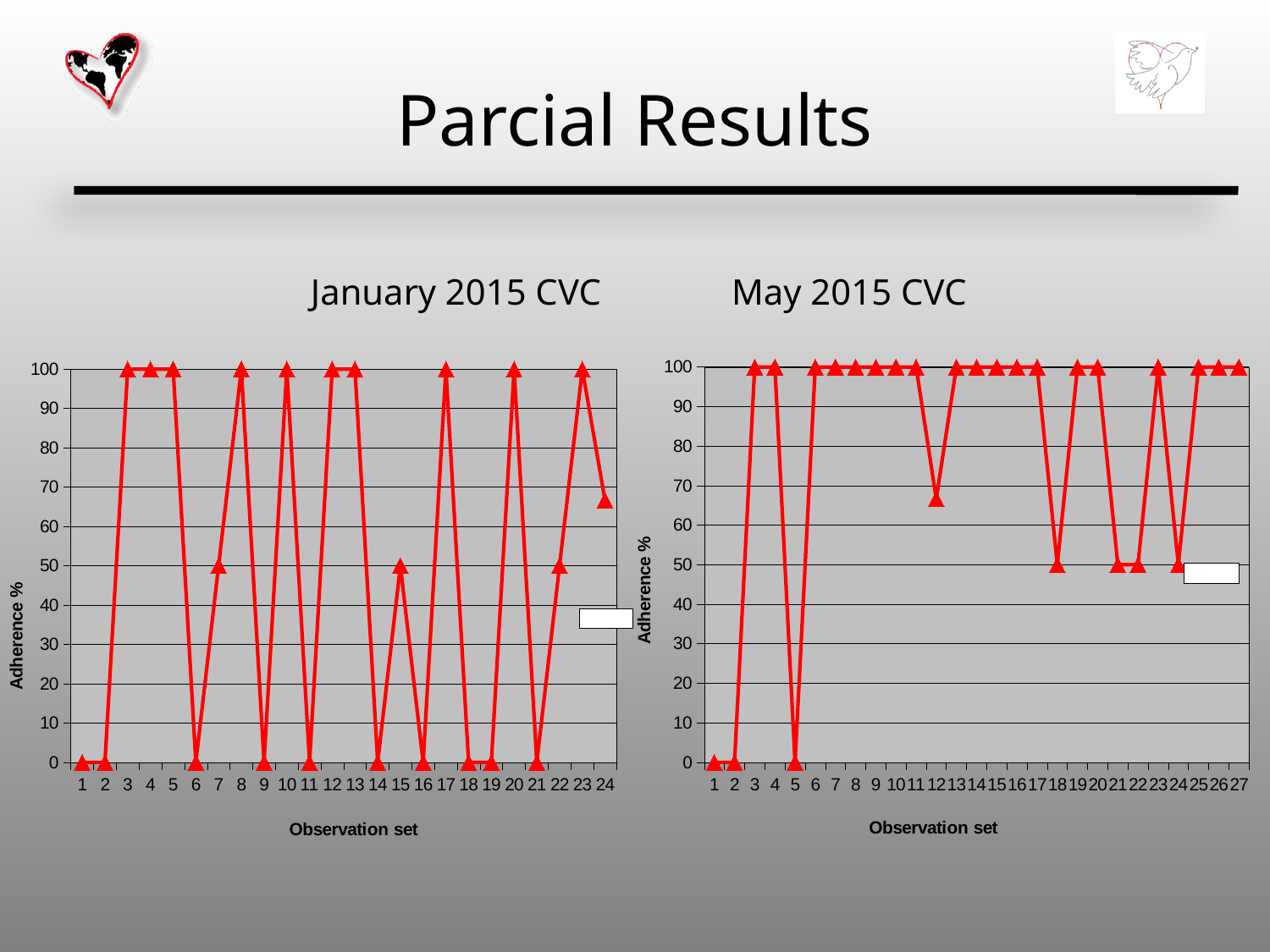
What kind of chart is the January 2015 CVC chart? line chart On the January 2015 CVC chart, what is the adherence % for observation set 7? 50 On the January 2015 CVC chart, what is the adherence % for observation set 18? 0 How many observation sets are plotted on the January 2015 CVC chart? 24 What is the y-axis title on the May 2015 CVC chart? Adherence % On the May 2015 CVC chart, which is larger, the value for observation set 21 or observation set 23? observation set 23 On the January 2015 CVC chart, what is the adherence % for observation set 3? 100 On the May 2015 CVC chart, what is the adherence % for observation set 18? 50 On the May 2015 CVC chart, what is the adherence % for observation set 5? 0 How many observation sets are plotted on the May 2015 CVC chart? 27 On the January 2015 CVC chart, is the value for observation set 24 greater or less than 60? greater On the May 2015 CVC chart, is the value for observation set 12 greater or less than 60? greater